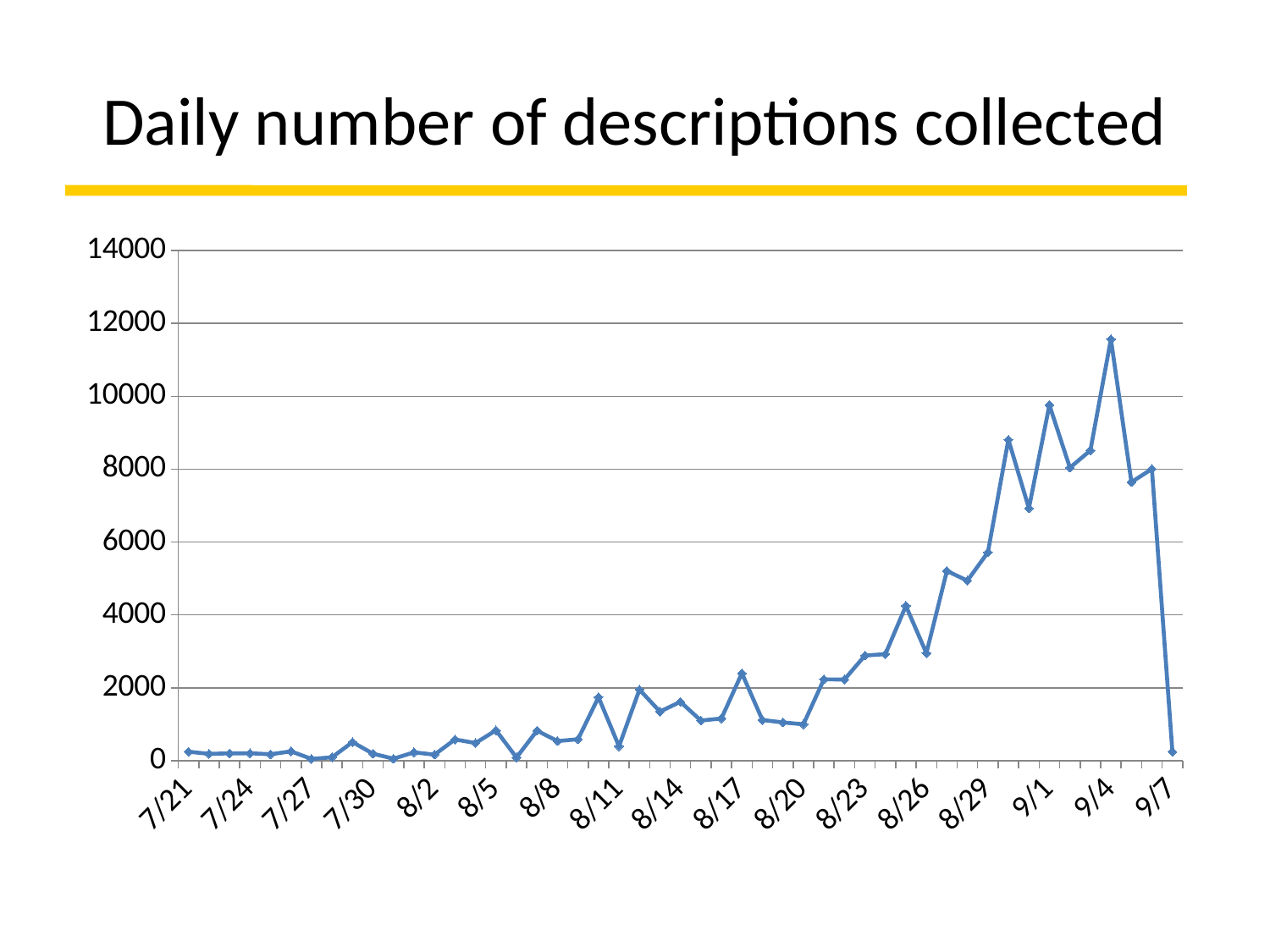
Is the value for 8/23 greater or less than 2000? greater Which date has the larger value, 9/4 or 9/1? 9/4 Is the value for 8/29 greater or less than 4000? greater Which date has the larger value, 8/29 or 8/23? 8/29 What kind of chart is shown on the slide? line chart Is the value for 9/1 greater or less than 8000? greater What is the title of the chart? Daily number of descriptions collected On which date does the chart reach its highest value? 9/4 Do the values generally rise or fall from 7/21 to 9/4? rise